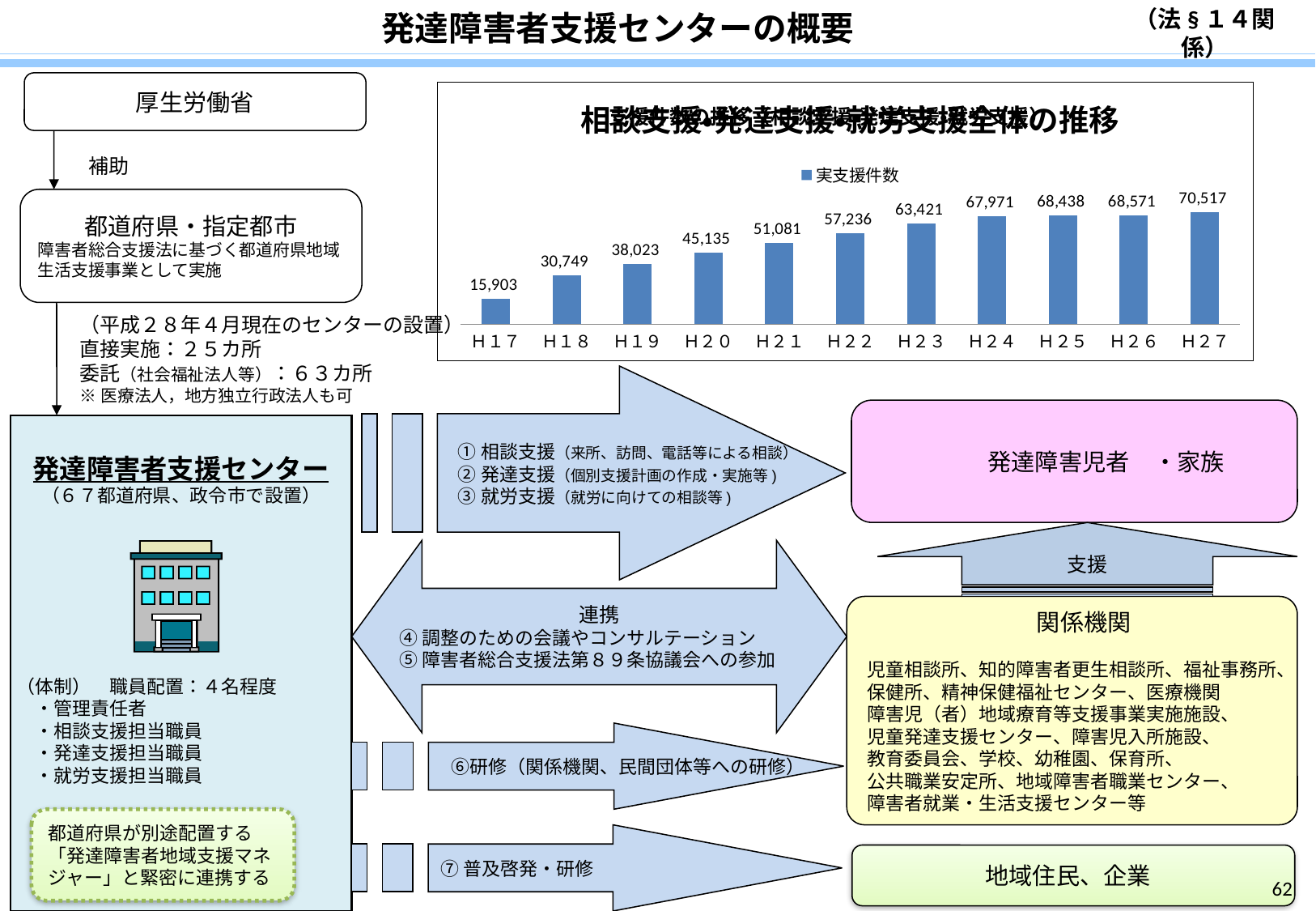
Which is larger in the bar chart, the value for H20 or the value for H21? H21 What is the value for H17 in the bar chart? 15,903 What kind of chart is shown on the slide? bar chart What is the difference between the values for H18 and H17 in the bar chart? 14,846 Which year has the lowest value in the bar chart? H17 Which year has the highest value in the bar chart? H27 How many years are shown on the x axis of the bar chart? 11 Do the values in the bar chart rise or fall from H17 to H27? rise What is the difference between the values for H27 and H17 in the bar chart? 54,614 What is the value for H22 in the bar chart? 57,236 What is the value for H27 in the bar chart? 70,517 How many series does the legend of the bar chart list? 1